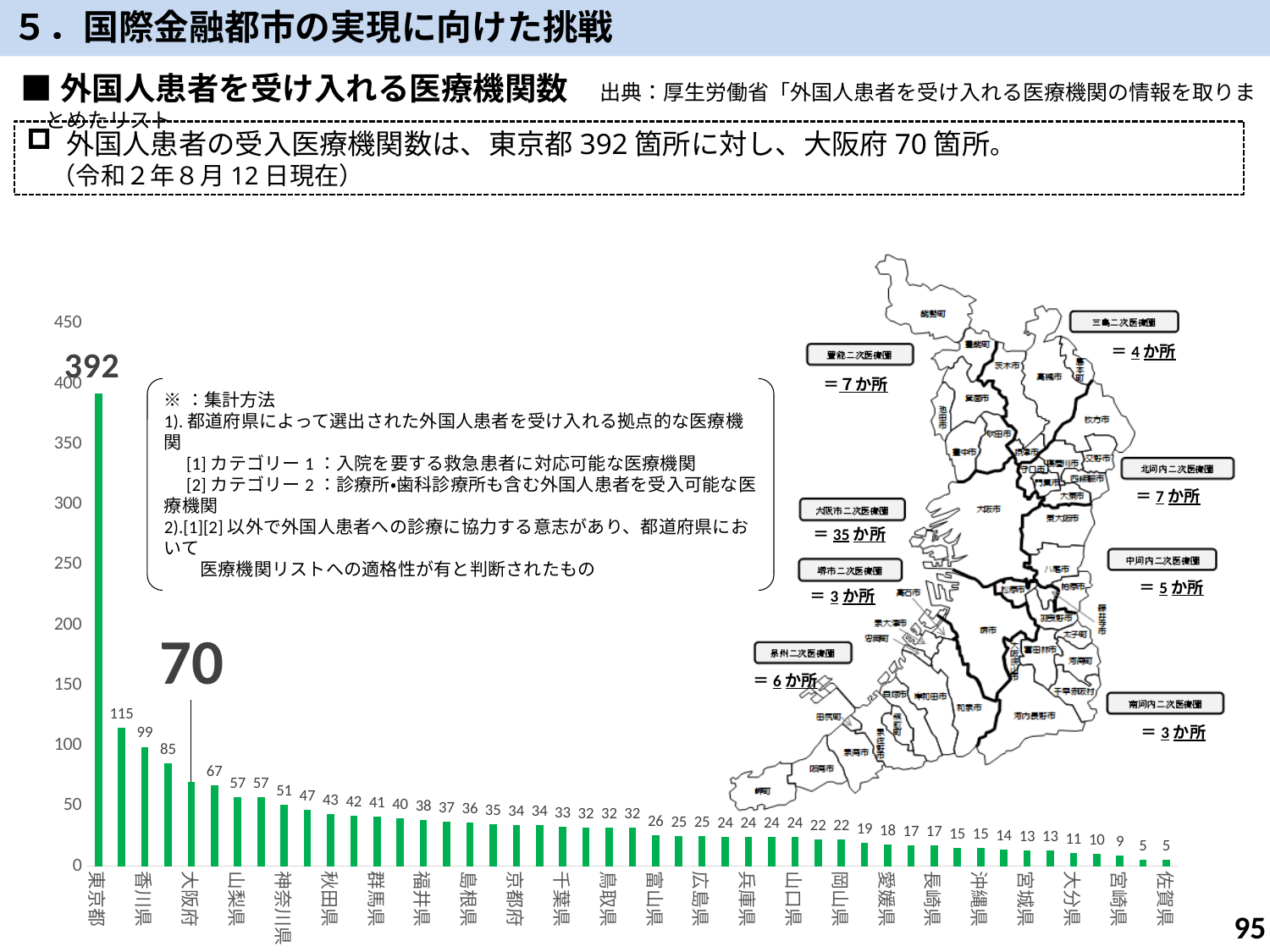
Which is larger, the value for 香川県 or the value for 大阪府? 香川県 Is the value for 大阪府 greater or less than 100? less What is the difference between the values for 東京都 and 大阪府? 322 How many bars are plotted in the bar chart? 47 What is the value for 大阪府 in the bar chart? 70 Which prefecture has the highest value in the bar chart? 東京都 What is the value for 東京都 in the bar chart? 392 What is the value for 香川県 in the bar chart? 99 Do the values rise or fall from left to right along the x axis? fall What is the lowest value shown in the bar chart? 5 What kind of chart is shown on the slide? bar chart What is the value for 佐賀県 in the bar chart? 5